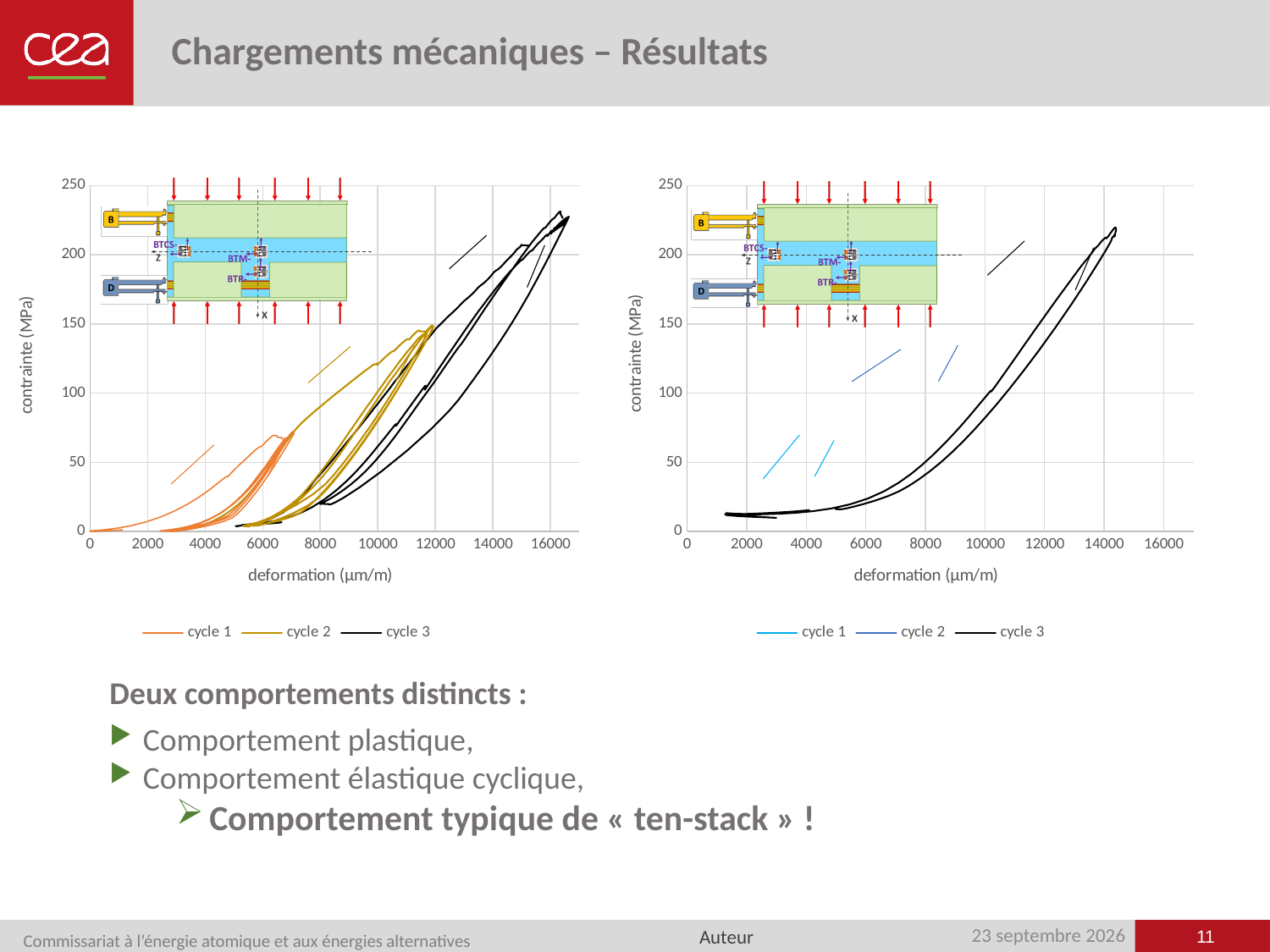
How many series does the legend of the left chart list? 3 What kind of chart is the left chart? line chart What is the x-axis title of the left chart? deformation (µm/m) On the right chart, is the peak stress of cycle 3 greater or less than 200 MPa? greater On the left chart, is the peak stress of cycle 1 greater or less than 100 MPa? less What is the y-axis title of the right chart? contrainte (MPa) On the left chart, which reaches a higher stress: cycle 2 or cycle 3? cycle 3 On the right chart, does the stress (contrainte) rise or fall as deformation increases along the x axis? rise On the left chart, which cycle reaches the lowest peak stress? cycle 1 How many series does the legend of the right chart list? 3 On the left chart, is the peak stress of cycle 3 greater or less than 200 MPa? greater On the left chart, which cycle reaches the highest stress (contrainte)? cycle 3